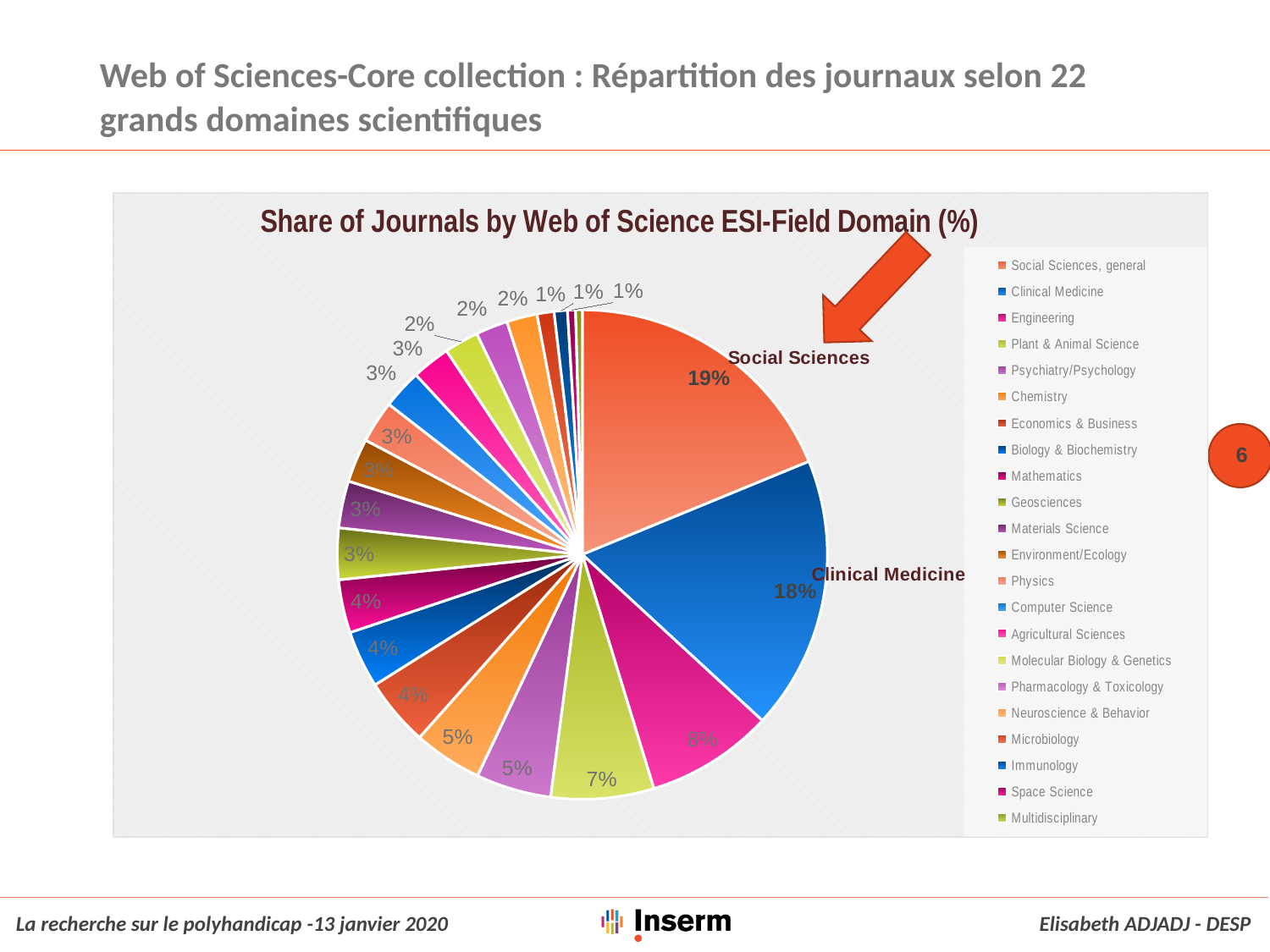
Which domain has the largest share of journals? Social Sciences What is the combined share of Social Sciences and Clinical Medicine? 37% What share of journals is in Social Sciences? 19% What is the difference in share between Social Sciences and Clinical Medicine? 1% What is the share of the third-largest slice, shown in magenta (Engineering)? 8% What kind of chart is shown on the slide? pie chart How many domains does the legend list? 22 Which is larger, the share for Social Sciences or the share for Clinical Medicine? Social Sciences What is the smallest share value labelled on the pie? 1% What share of journals is in Clinical Medicine? 18% Which legend entry is listed first? Social Sciences, general What is the title of the chart? Share of Journals by Web of Science ESI-Field Domain (%)